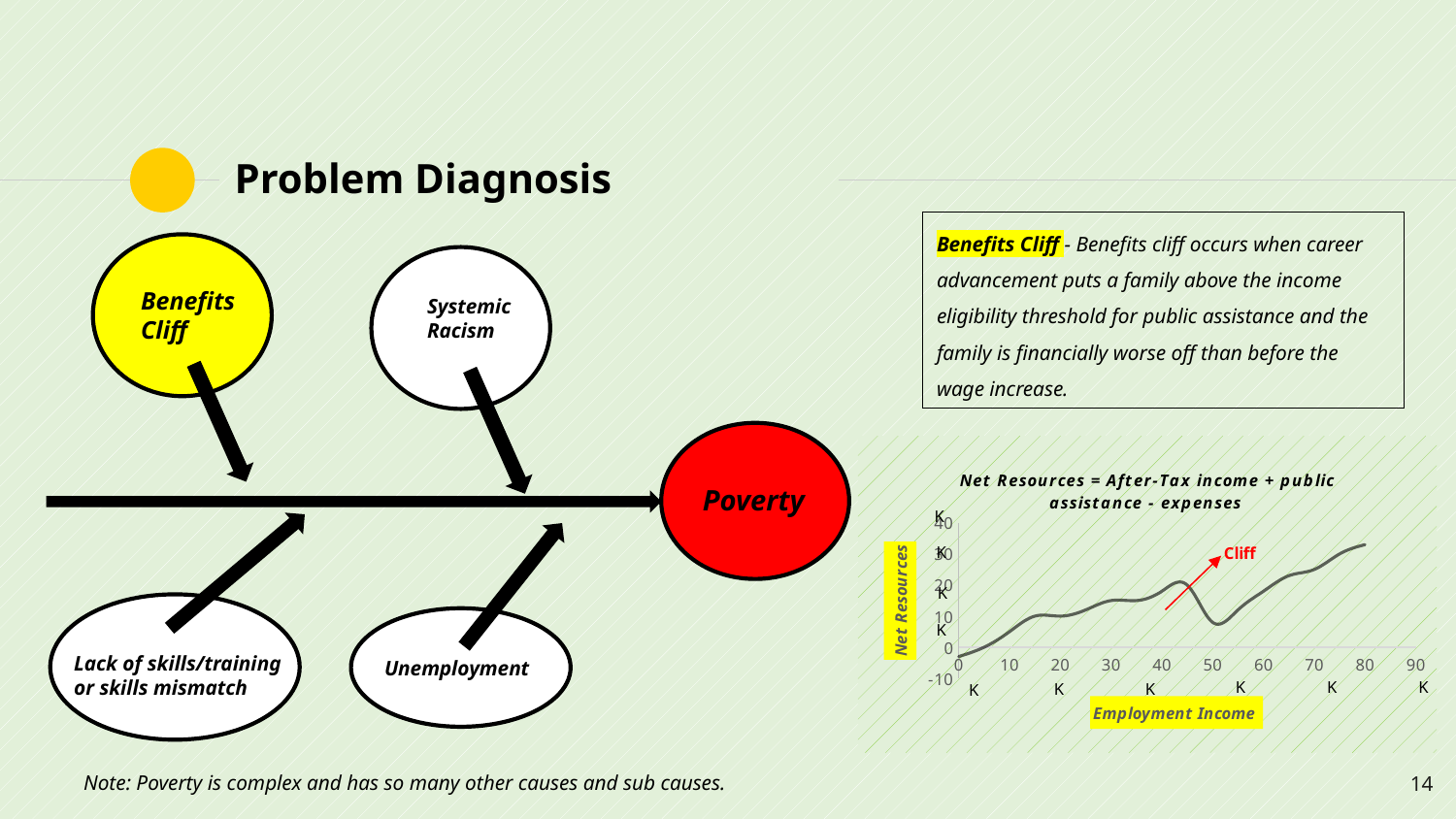
Is the value of net resources at an employment income of 20K greater or less than 0? greater What kind of chart is shown on the right side of the slide? line chart Is the value of net resources at an employment income of 40K greater or less than 10K? greater How many tick marks are labelled on the x axis of the chart? 10 What is the label of the x axis of the chart? Employment Income What is the title of the chart on the slide? Net Resources = After-Tax income + public assistance - expenses What is the highest value labelled on the y axis of the chart? 40K Is the value of net resources at an employment income of 70K greater or less than 20K? greater Overall, do net resources rise or fall as employment income increases from 0 to 90K? rise Between which two employment income ticks does the line drop sharply (the 'Cliff')? 40K and 50K